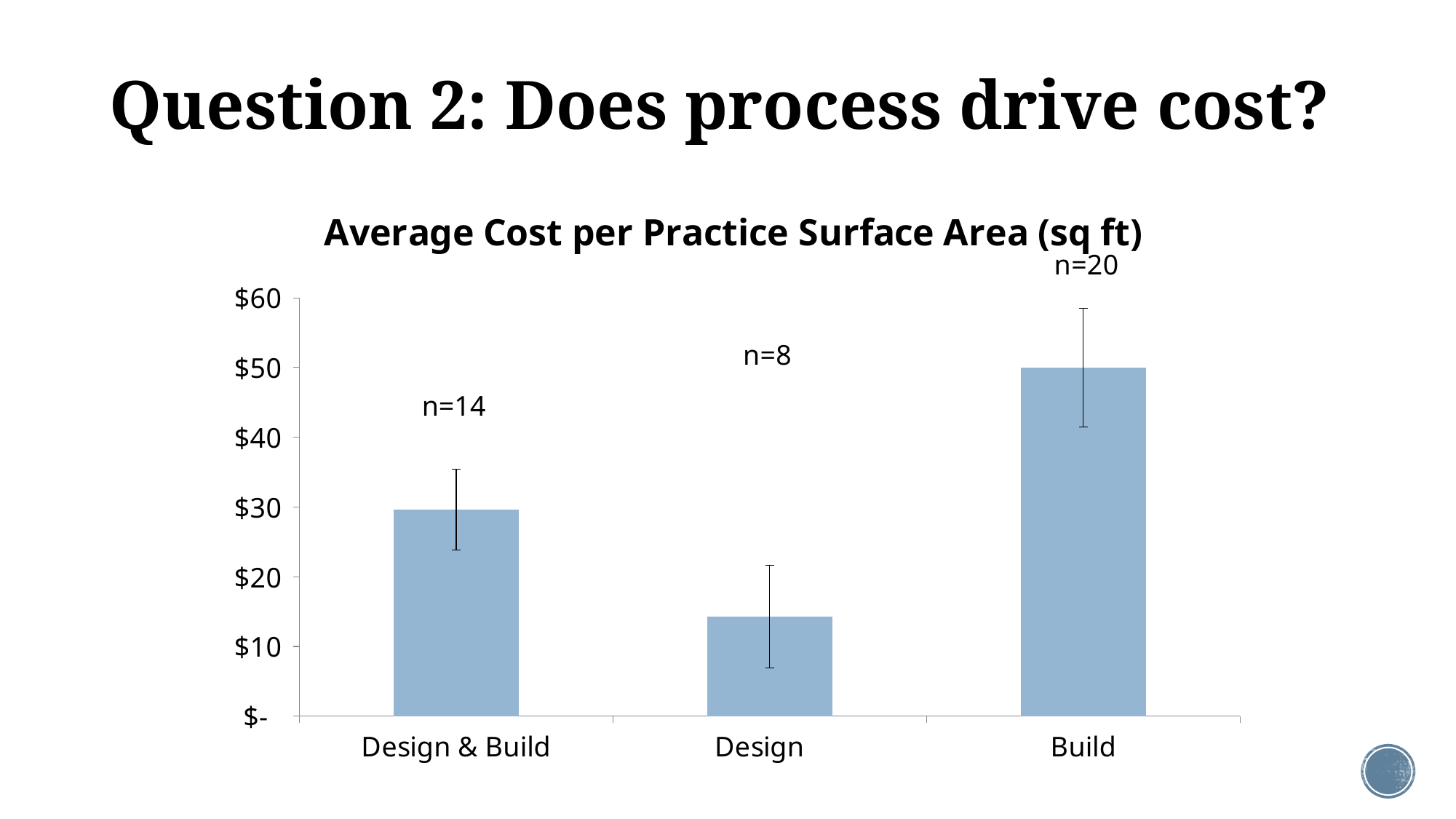
What kind of chart is shown on the slide? bar chart What is the title of the chart? Average Cost per Practice Surface Area (sq ft) Is the value for Design & Build greater or less than $20? greater Which category has the lowest average cost per practice surface area? Design What sample size (n) is printed above the Design bar? n=8 Which has a higher average cost per square foot, Design & Build or Design? Design & Build How many categories are shown on the x axis of the chart? 3 Is the value for Design greater or less than $20? less What sample size (n) is printed above the Build bar? n=20 Is the value for Build greater or less than $40? greater Which category has the highest average cost per practice surface area? Build What sample size (n) is printed above the Design & Build bar? n=14